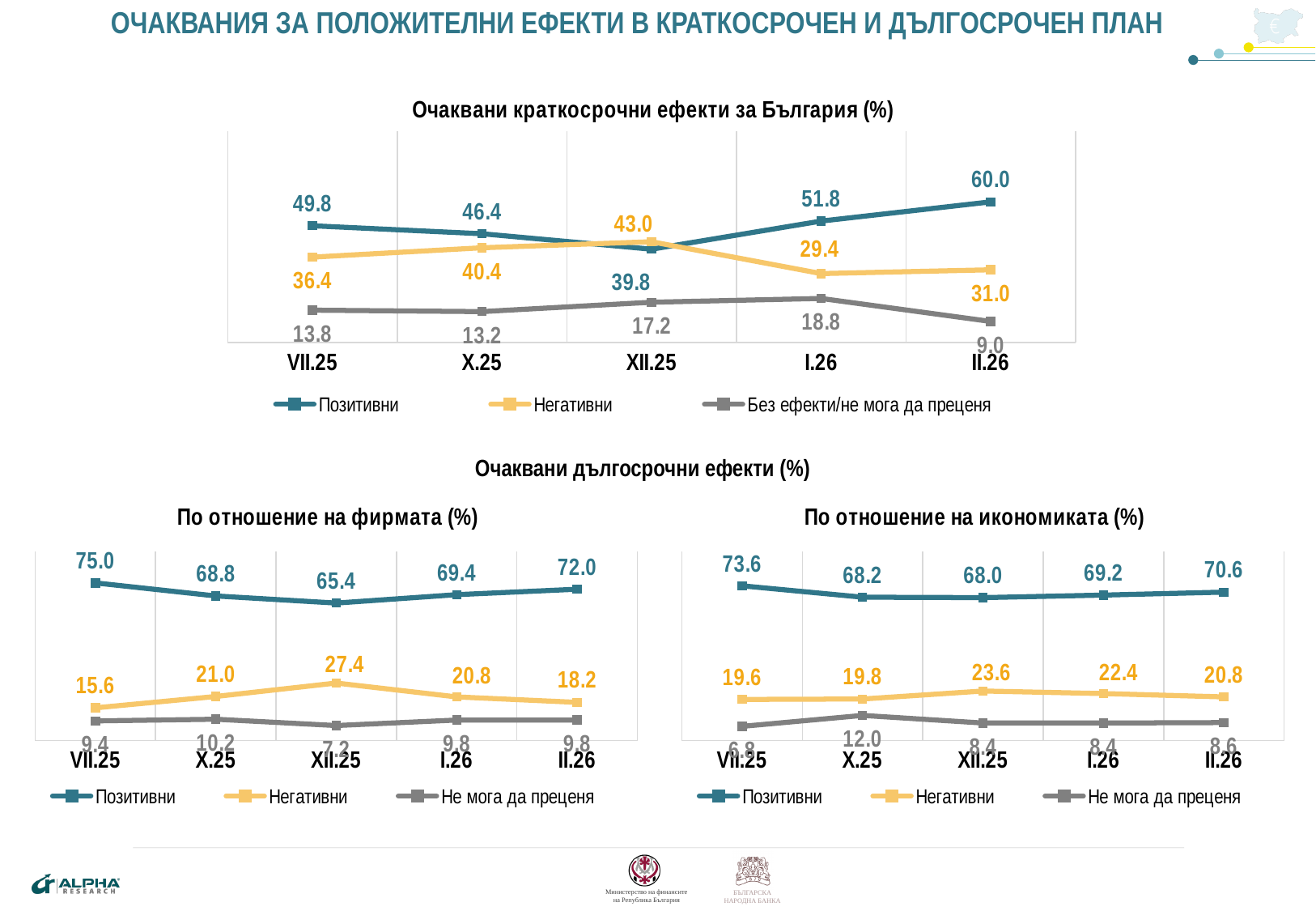
In the chart 'По отношение на фирмата (%)', what is the value of Негативни at XII.25? 27.4 In the chart 'Очаквани краткосрочни ефекти за България (%)', what is the difference between Позитивни and Негативни at I.26? 22.4 In the chart 'Очаквани краткосрочни ефекти за България (%)', what is the value of Негативни at XII.25? 43.0 How many time periods are shown on the x axis of the chart 'По отношение на икономиката (%)'? 5 In the chart 'Очаквани краткосрочни ефекти за България (%)', at which period is the Позитивни series lowest? XII.25 In the chart 'По отношение на икономиката (%)', what is the value of Не мога да преценя at X.25? 12.0 In the chart 'По отношение на фирмата (%)', at which period is the Позитивни series highest? VII.25 In the chart 'Очаквани краткосрочни ефекти за България (%)', what is the value of Позитивни at II.26? 60.0 In the chart 'Очаквани краткосрочни ефекти за България (%)', which is larger at XII.25: Позитивни or Негативни? Негативни In the chart 'По отношение на икономиката (%)', what is the difference between Позитивни at VII.25 and Позитивни at II.26? 3.0 What kind of chart is 'По отношение на фирмата (%)'? Line chart How many series does the legend of the chart 'Очаквани краткосрочни ефекти за България (%)' list? 3